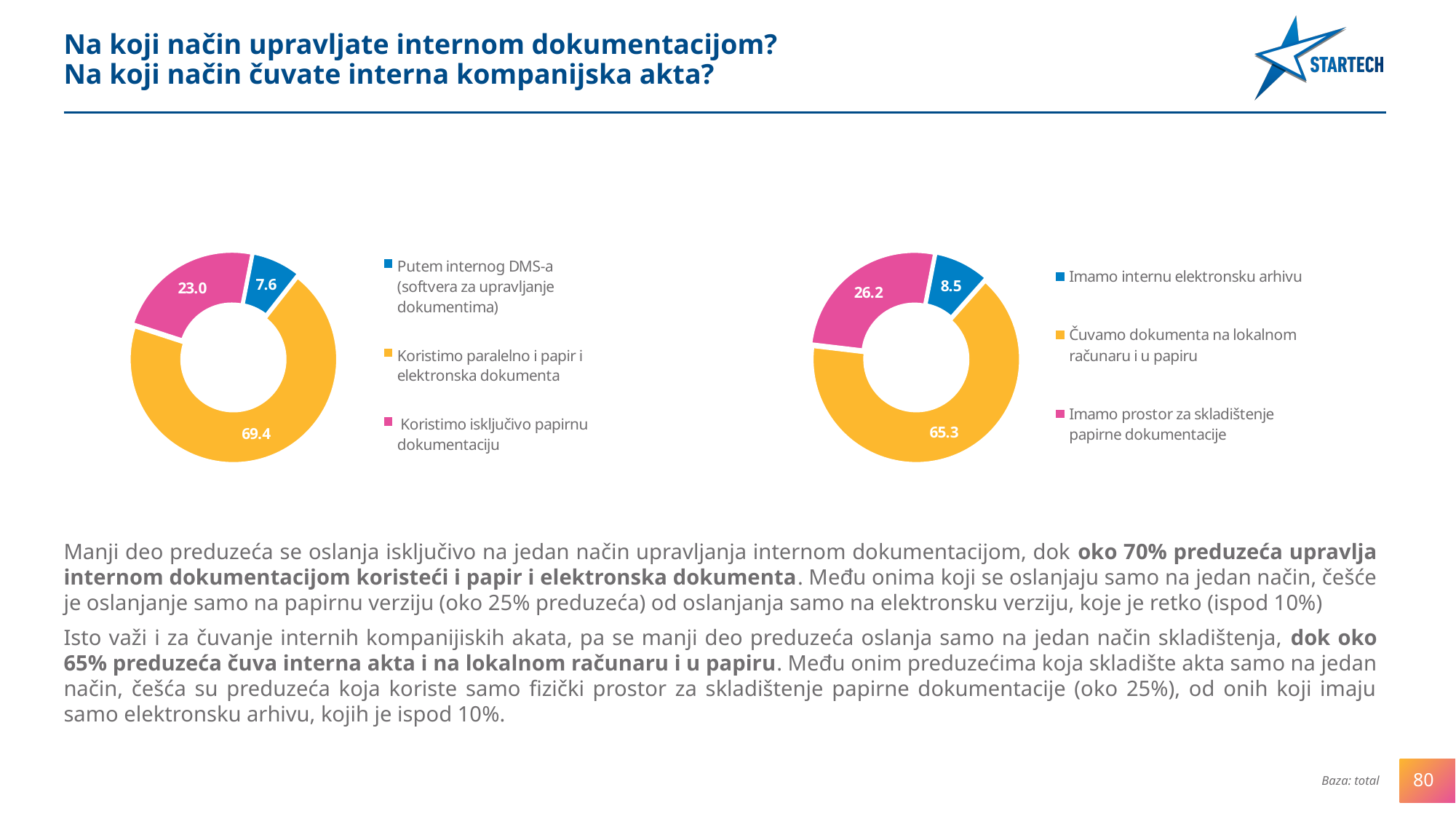
In the left doughnut chart, what is the difference between the values for 'Koristimo isključivo papirnu dokumentaciju' and 'Putem internog DMS-a'? 15.4 In the right doughnut chart, what is the value for 'Imamo prostor za skladištenje papirne dokumentacije'? 26.2 In the left doughnut chart, what is the value for 'Putem internog DMS-a (softvera za upravljanje dokumentima)'? 7.6 How many categories does the right doughnut chart show? 3 What type of chart is used on the left side of the slide? Doughnut chart In the right doughnut chart, which category has the smallest share? Imamo internu elektronsku arhivu In the left doughnut chart, which category has the largest share? Koristimo paralelno i papir i elektronska dokumenta In the left doughnut chart, which colour represents 'Koristimo isključivo papirnu dokumentaciju'? Pink Which is larger: the value for 'Koristimo isključivo papirnu dokumentaciju' in the left chart or the value for 'Imamo prostor za skladištenje papirne dokumentacije' in the right chart? Imamo prostor za skladištenje papirne dokumentacije In the right doughnut chart, what is the difference between the values for 'Čuvamo dokumenta na lokalnom računaru i u papiru' and 'Imamo prostor za skladištenje papirne dokumentacije'? 39.1 In the left doughnut chart, what is the value for 'Koristimo paralelno i papir i elektronska dokumenta'? 69.4 In the right doughnut chart, what is the value for 'Imamo internu elektronsku arhivu'? 8.5